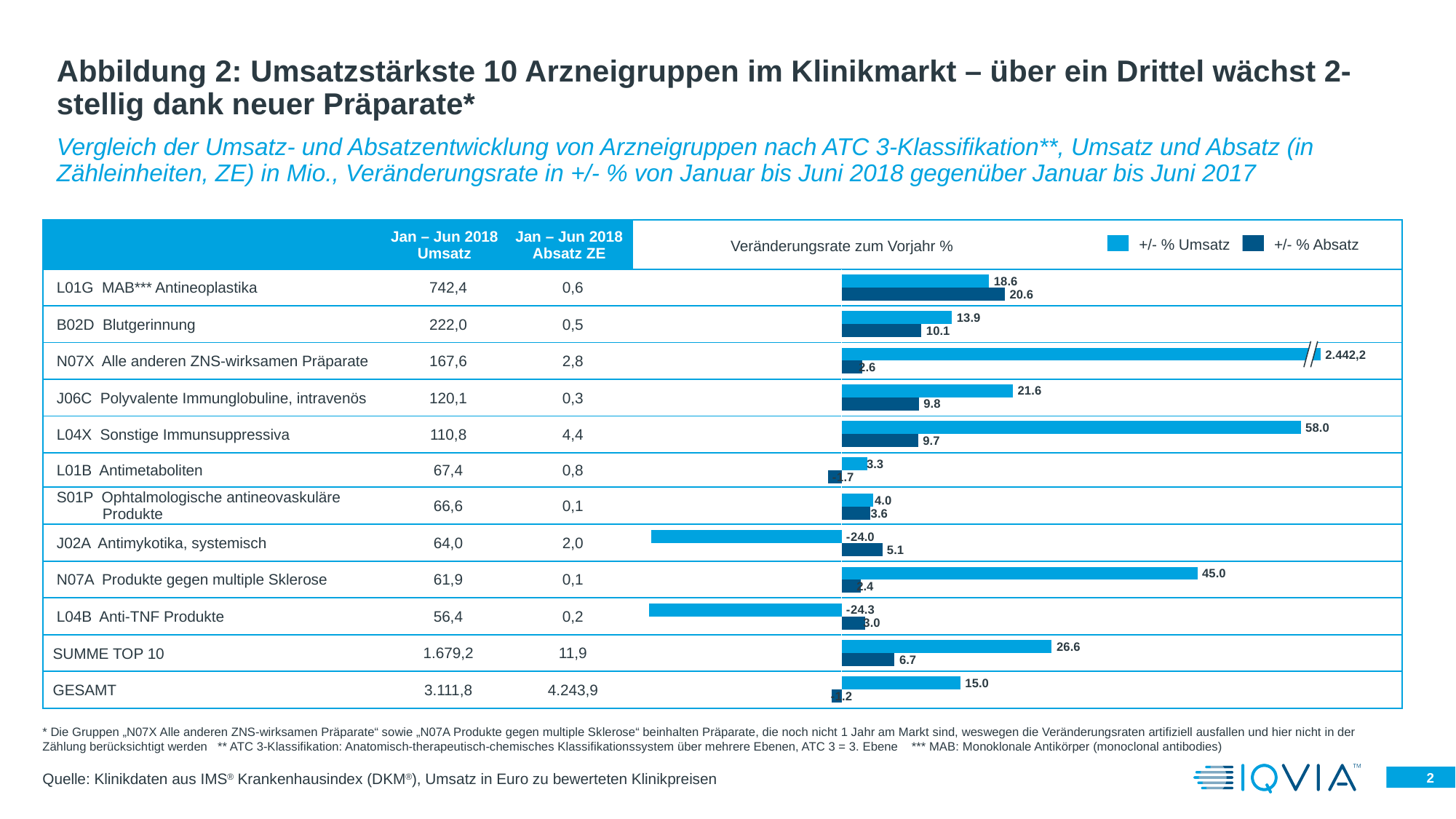
What are the two series named in the legend of the Veränderungsrate chart? +/- % Umsatz and +/- % Absatz How many series does the legend of the Veränderungsrate chart list? 2 Which has the larger +/- % Umsatz value: L04X Sonstige Immunsuppressiva or N07A Produkte gegen multiple Sklerose? L04X Sonstige Immunsuppressiva What is the +/- % Umsatz value for L01G MAB*** Antineoplastika? 18.6 Which Arzneigruppe has the highest +/- % Umsatz value? N07X Alle anderen ZNS-wirksamen Präparate What is the +/- % Umsatz value for SUMME TOP 10? 26.6 What is the +/- % Absatz value for B02D Blutgerinnung? 10.1 What is the +/- % Umsatz value for L04X Sonstige Immunsuppressiva? 58.0 What kind of chart shows the Veränderungsrate zum Vorjahr %? Bar chart What is the difference between the +/- % Umsatz and +/- % Absatz values for J06C Polyvalente Immunglobuline, intravenös? 11.8 Which Arzneigruppe has the lowest +/- % Umsatz value? L04B Anti-TNF Produkte Which Arzneigruppe has the highest +/- % Absatz value? L01G MAB*** Antineoplastika